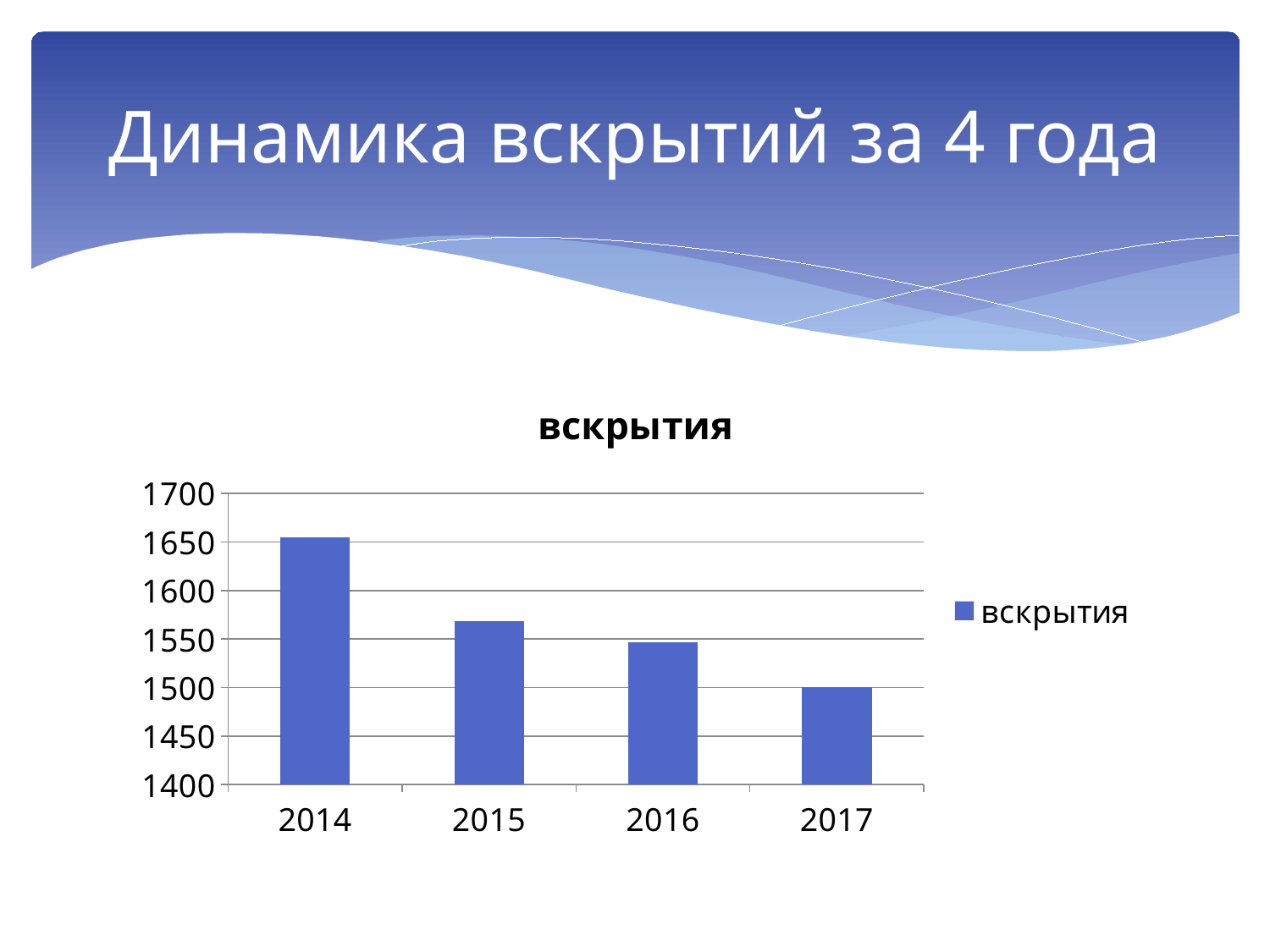
How many years are shown on the x axis of the chart? 4 What is the title of the chart? вскрытия Which year has the highest value in the chart? 2014 Which year has the lowest value in the chart? 2017 Is the value for 2017 greater or less than 1550? less Is the value for 2014 greater or less than 1600? greater Which is larger, the value for 2014 or the value for 2015? 2014 Is the value for 2015 greater or less than 1600? less What kind of chart is shown on the slide? bar chart Do the values rise or fall from 2014 to 2017? fall How many series does the chart legend list? 1